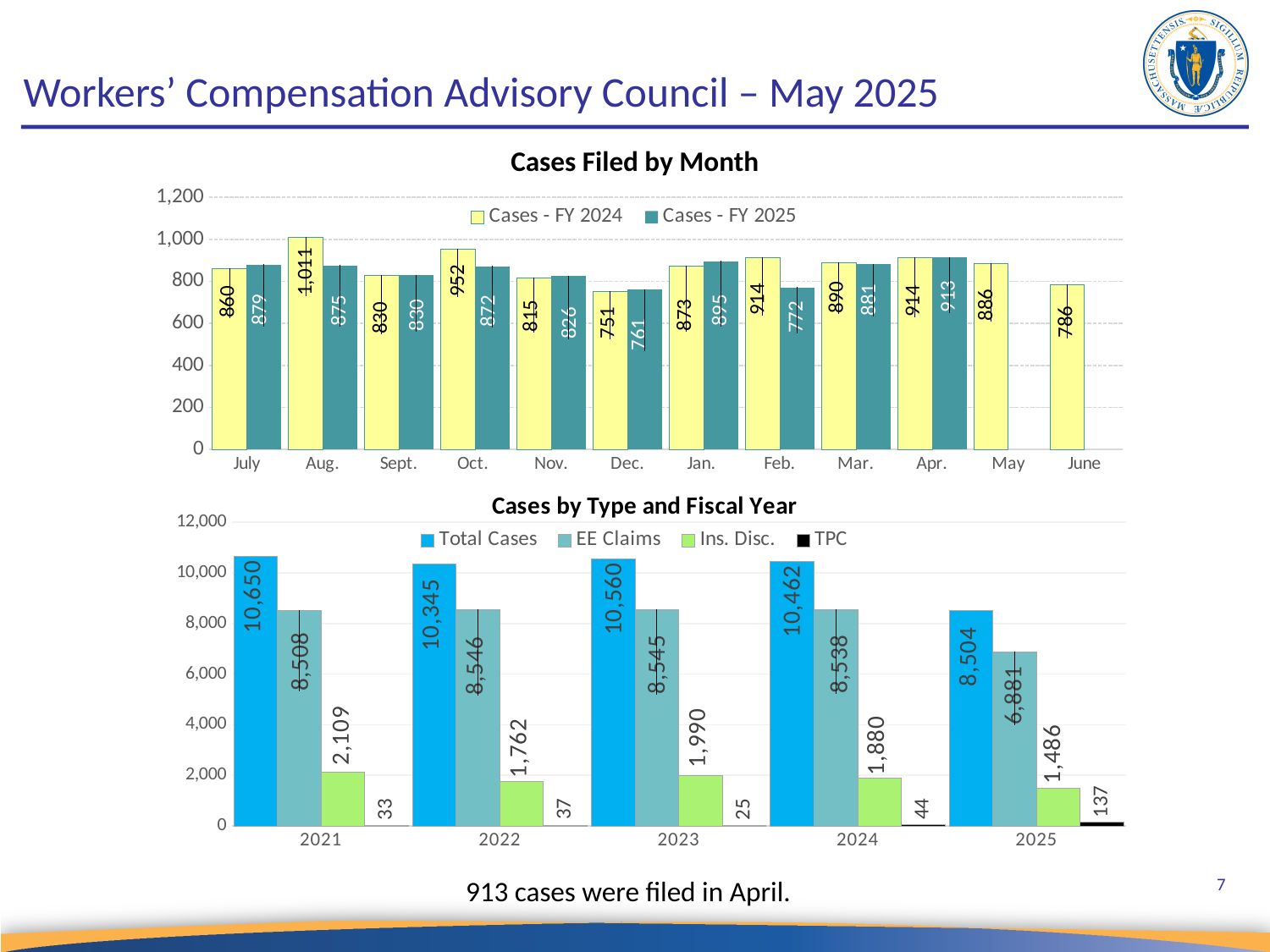
In the 'Cases by Type and Fiscal Year' chart, what is the value for TPC in 2025? 137 In the 'Cases by Type and Fiscal Year' chart, what is the value for Total Cases in 2023? 10,560 In the 'Cases Filed by Month' chart, what is the value for Cases - FY 2024 in August? 1,011 In the 'Cases Filed by Month' chart, what is the difference between Cases - FY 2024 and Cases - FY 2025 in October? 80 In the 'Cases Filed by Month' chart, which month has the lowest value for Cases - FY 2025? Dec. In the 'Cases by Type and Fiscal Year' chart, which is larger: Ins. Disc. in 2021 or Ins. Disc. in 2022? Ins. Disc. in 2021 What kind of chart is 'Cases by Type and Fiscal Year'? Bar chart In the 'Cases Filed by Month' chart, which month has the highest value for Cases - FY 2024? Aug. In the 'Cases by Type and Fiscal Year' chart, how many years are shown on the x axis? 5 In the 'Cases by Type and Fiscal Year' chart, which year has the lowest value for EE Claims? 2025 In the 'Cases Filed by Month' chart, what is the value for Cases - FY 2025 in February? 772 In the 'Cases Filed by Month' chart, how many series does the legend list? 2